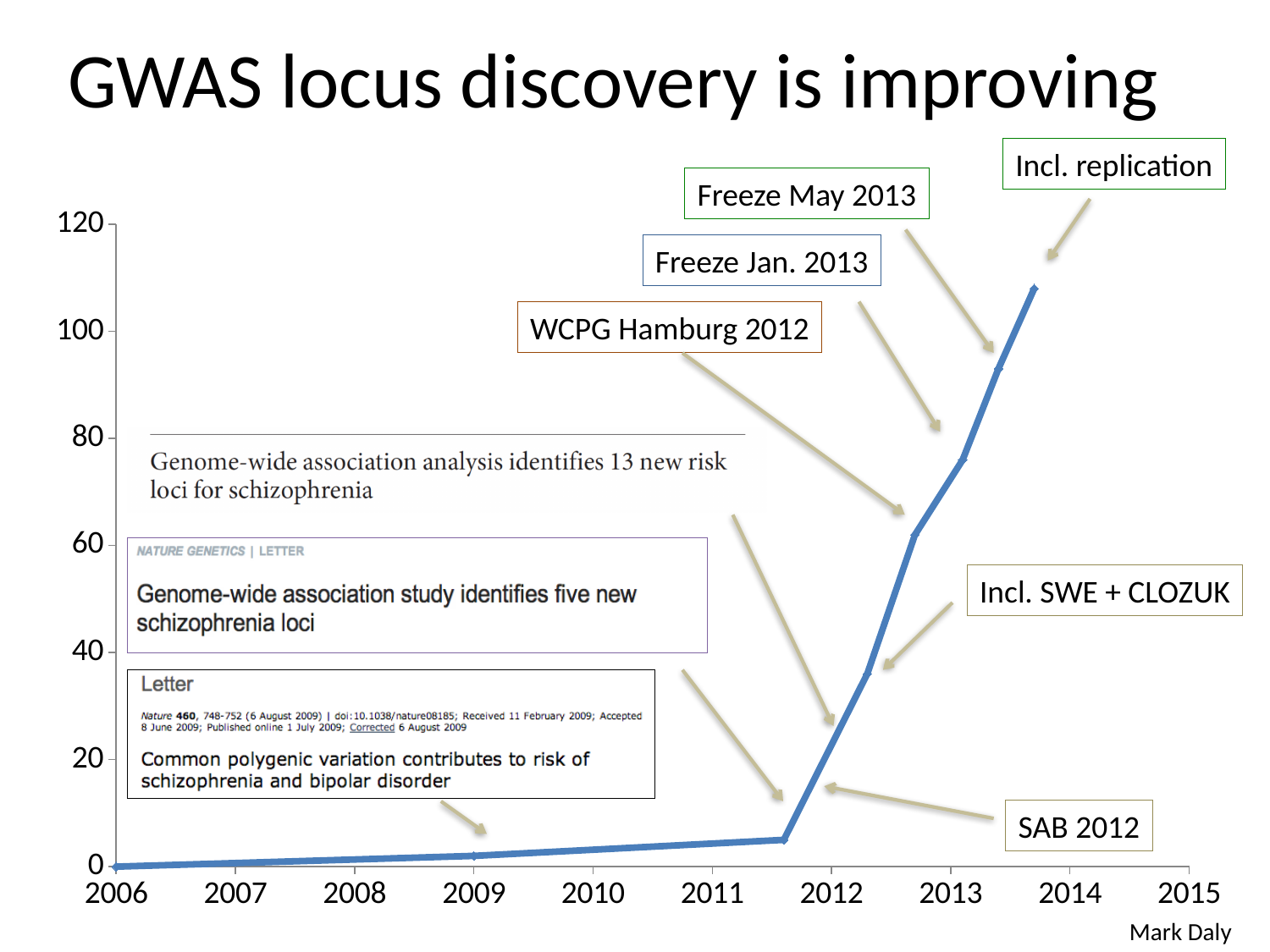
Do the values on the line rise or fall as the years increase from 2006 to 2014? rise Is the value at the point labelled 'WCPG Hamburg 2012' greater or less than 40? greater Is the value of the line at 2009 greater or less than 20? less What is the last year labelled on the x axis? 2015 What is the highest value shown on the y axis? 120 What is the title of the slide containing the chart? GWAS locus discovery is improving Is the value at the point labelled 'Freeze May 2013' greater or less than 80? greater What kind of chart is shown on the slide? line chart Which is larger, the value at the point labelled 'Freeze May 2013' or the value at the point labelled 'WCPG Hamburg 2012'? Freeze May 2013